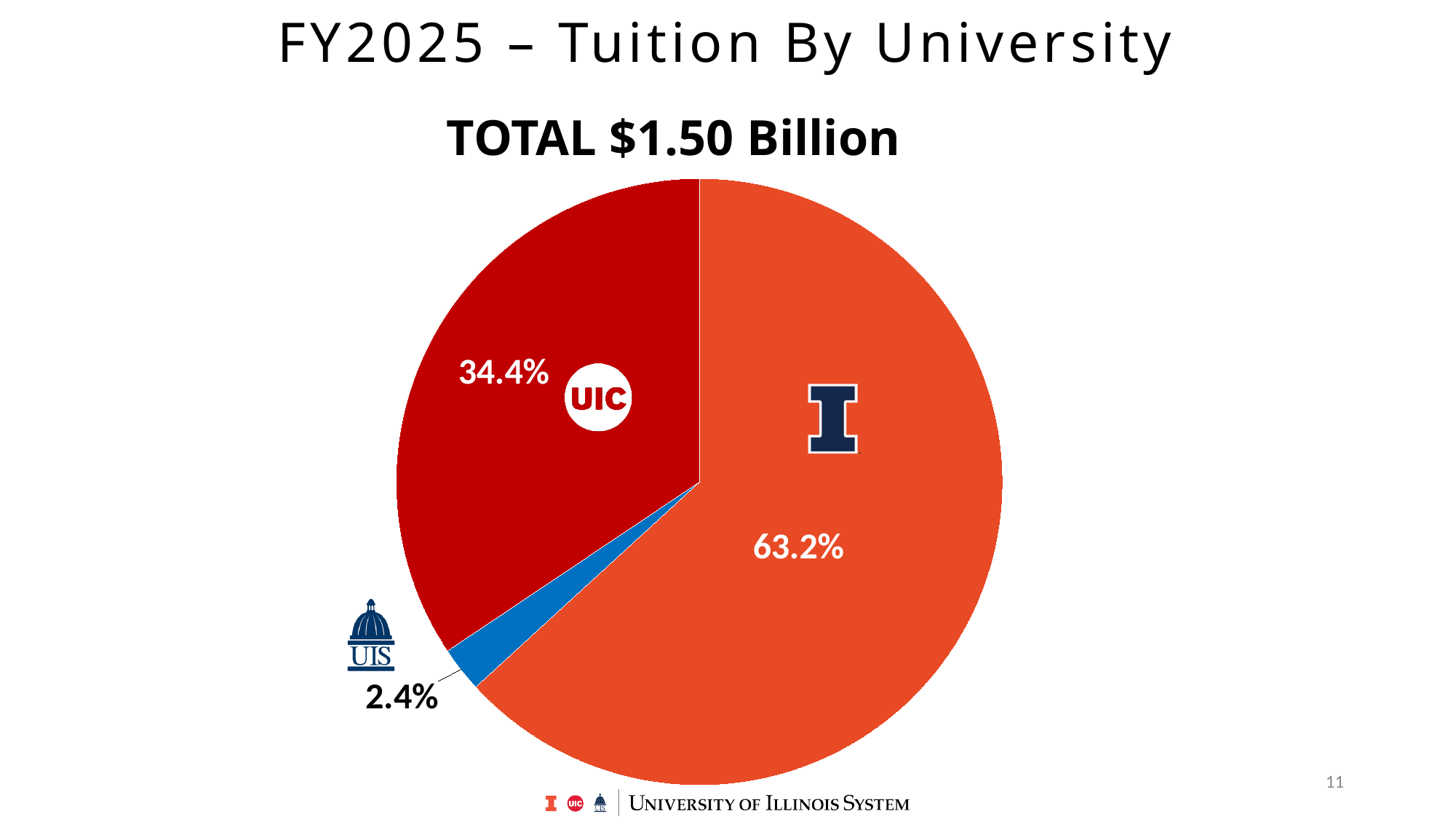
What colour is the UIS slice of the pie chart? blue Is the UIC share greater or less than 50%? less What kind of chart is shown on the slide? pie chart How many slices does the pie chart have? 3 Which is larger, the UIC share or the UIS share? UIC What is the difference in percentage points between the UIC slice and the UIS slice? 32.0 percentage points What share of tuition does the UIS slice represent? 2.4% What share of tuition does the orange slice with the Block I logo represent? 63.2% Which slice of the pie is the largest? the orange slice with the Block I logo (63.2%) What share of tuition does the UIC slice represent? 34.4% Which university has the smallest share of tuition in the pie chart? UIS What total amount is stated above the pie chart? $1.50 Billion